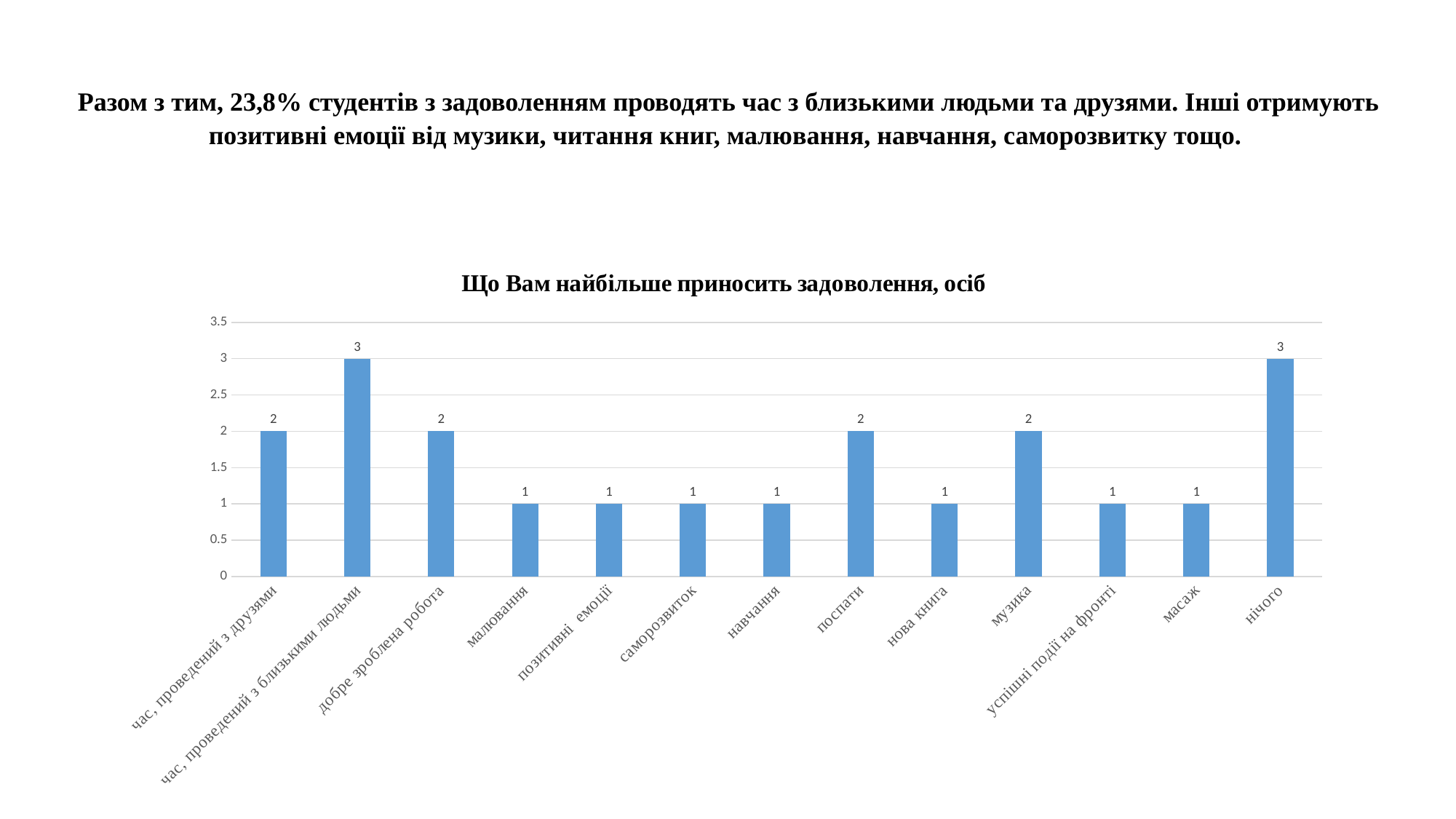
What is the value for "час, проведений з близькими людьми"? 3 What is the value for "музика"? 2 How many categories are shown on the chart? 13 What is the title of the chart? Що Вам найбільше приносить задоволення, осіб What type of chart is shown on the slide? bar chart What is the difference between the values for "нічого" and "навчання"? 2 What is the value for "поспати"? 2 Which has a larger value, "добре зроблена робота" or "нова книга"? добре зроблена робота Which two categories share the highest value on the chart? час, проведений з близькими людьми and нічого What is the difference between the values for "час, проведений з друзями" and "саморозвиток"? 1 Which has a larger value, "малювання" or "нічого"? нічого What is the value for "масаж"? 1